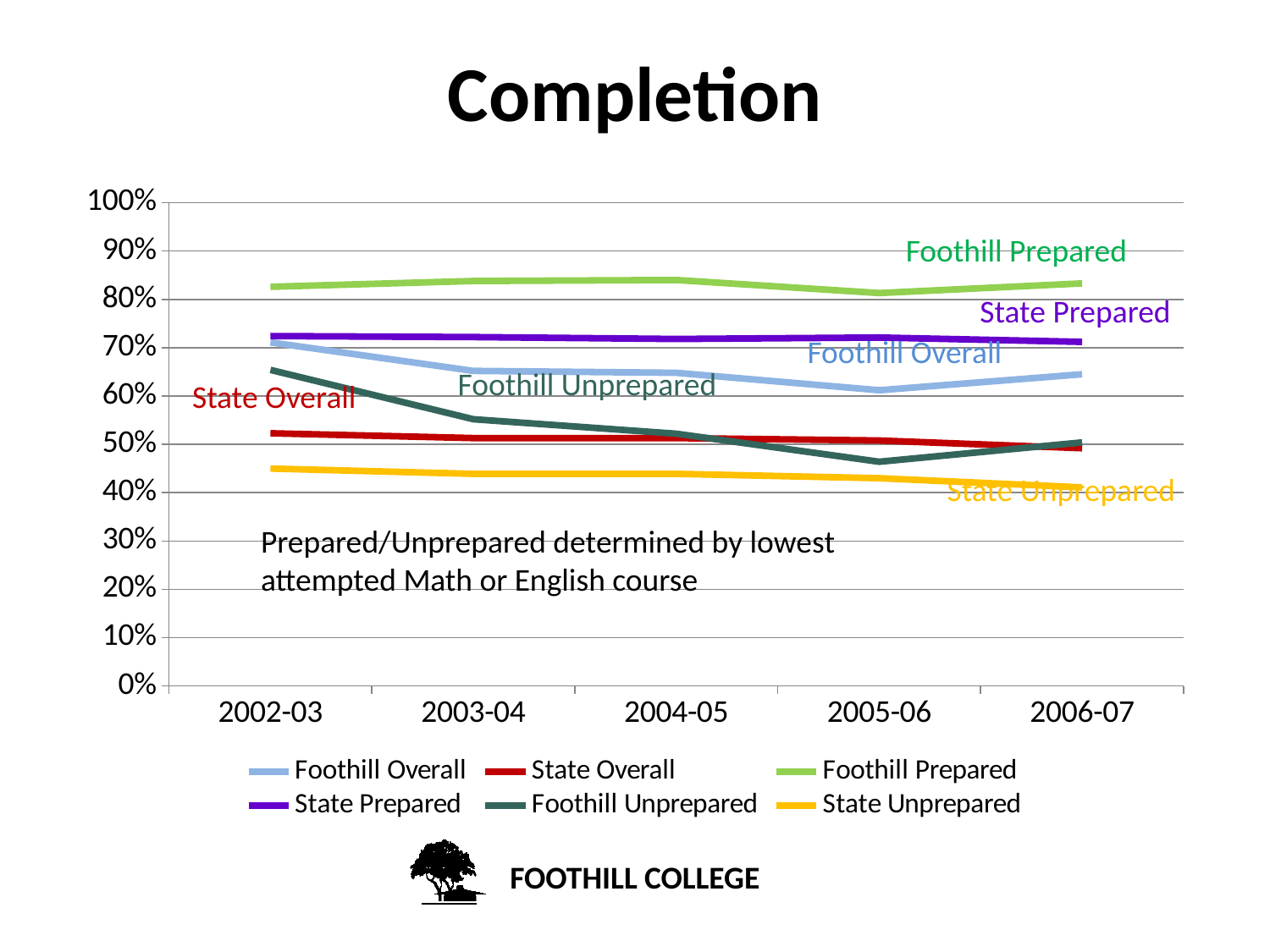
How many series does the legend list? 6 In 2002-03, which is larger: Foothill Overall or State Overall? Foothill Overall Is the value for Foothill Prepared in 2002-03 greater or less than 80%? greater Which series has the lowest value in 2002-03? State Unprepared What kind of chart is shown on the slide? line chart How many academic years are shown on the x axis? 5 Does the Foothill Unprepared line rise or fall from 2002-03 to 2005-06? fall Which series has the highest value in 2006-07? Foothill Prepared Is the value for State Prepared in 2004-05 greater or less than 60%? greater Is the value for Foothill Unprepared in 2005-06 greater or less than 50%? less What is the title of the slide? Completion